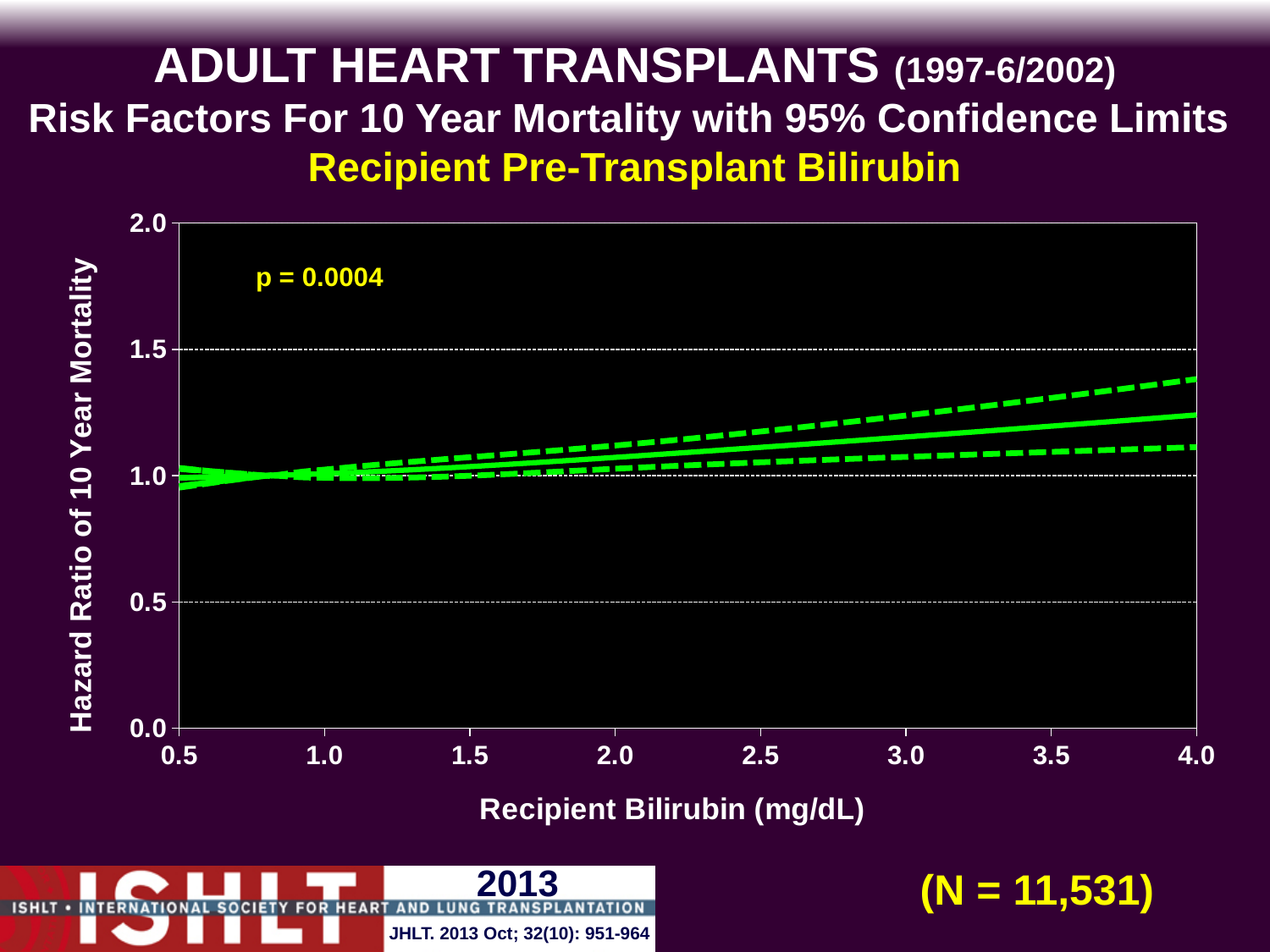
Is the hazard ratio (solid line) at a recipient bilirubin of 4.0 mg/dL greater or less than 1.5? less How many lines are plotted on the chart (including the confidence limit lines)? 3 What is the label of the x axis of the chart? Recipient Bilirubin (mg/dL) Is the lower 95% confidence limit (lower dashed line) at a recipient bilirubin of 4.0 mg/dL greater or less than 1.0? greater What p-value is printed on the chart? p = 0.0004 Is the hazard ratio (solid line) at a recipient bilirubin of 4.0 mg/dL greater or less than 1.0? greater What is the highest value labelled on the y axis of the chart? 2.0 What kind of chart is shown on the slide? line chart How many tick labels are shown on the x axis of the chart? 8 Does the hazard ratio of 10 year mortality rise or fall as recipient bilirubin increases from 0.5 to 4.0 mg/dL? rise